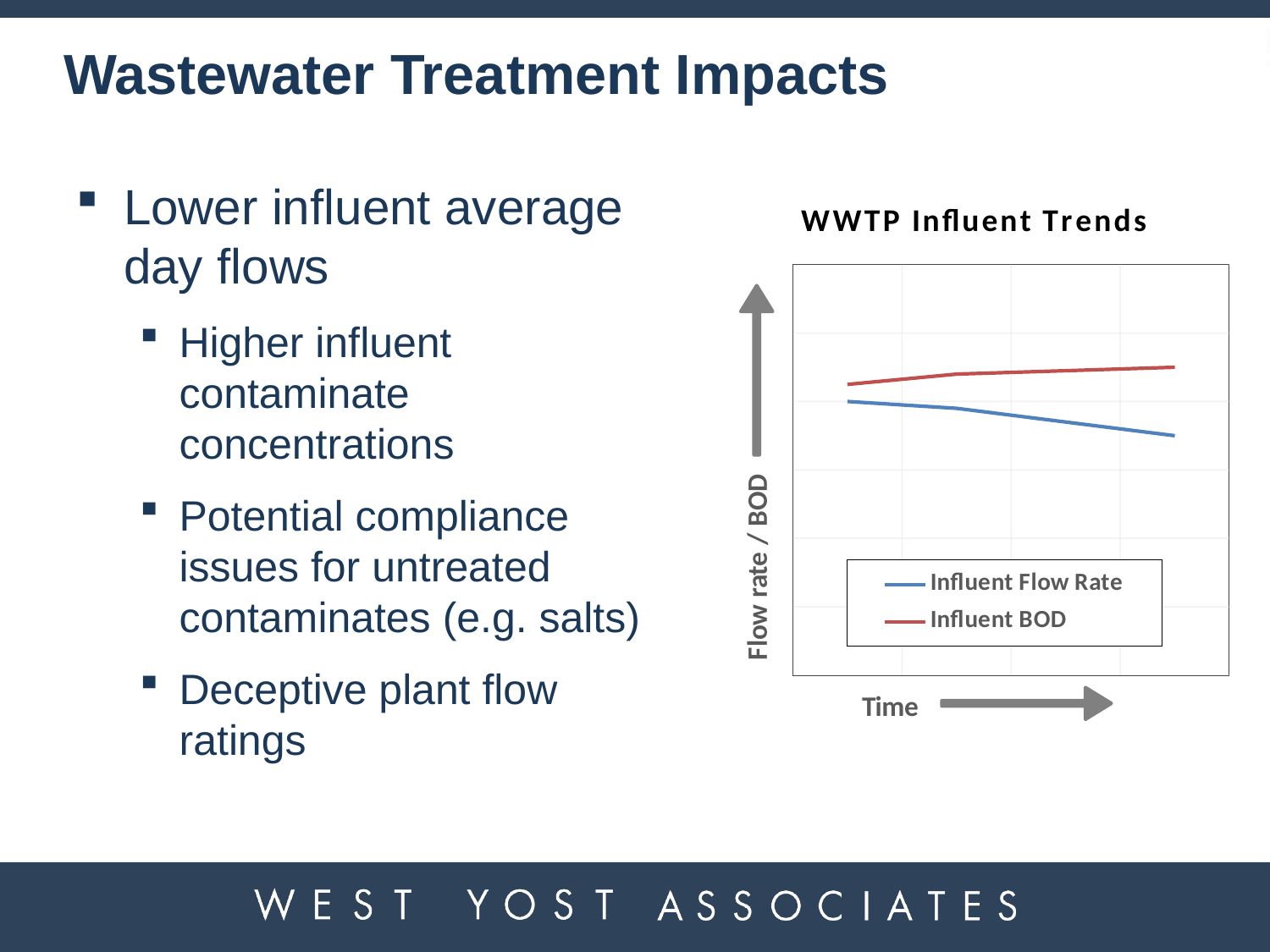
What colour is the Influent BOD line? red What label is shown on the vertical axis of the chart? Flow rate / BOD How many series does the legend of the WWTP Influent Trends chart list? 2 What is the title of the chart? WWTP Influent Trends What kind of chart is shown on the slide? line chart Which series is plotted higher on the chart at the right end of the time axis, Influent Flow Rate or Influent BOD? Influent BOD Does the Influent BOD line rise or fall over time? rise Does the Influent Flow Rate line rise or fall over time? fall Which series is plotted lower on the chart at the right end of the time axis? Influent Flow Rate